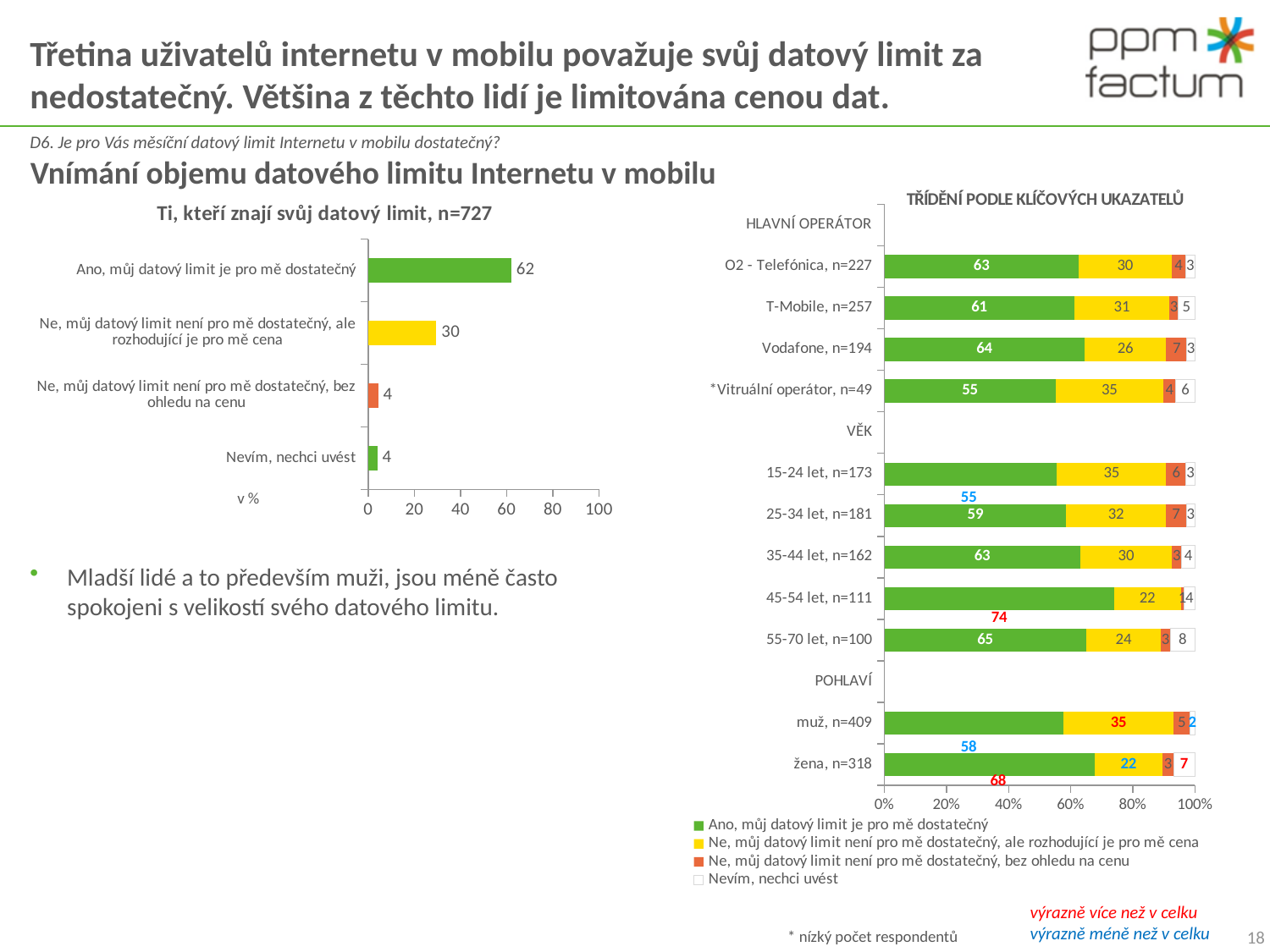
In the right chart 'TŘÍDĚNÍ PODLE KLÍČOVÝCH UKAZATELŮ', what is the value of 'Ano, můj datový limit je pro mě dostatečný' for '45-54 let, n=111'? 74 In the right chart 'TŘÍDĚNÍ PODLE KLÍČOVÝCH UKAZATELŮ', which has the larger value for 'Ano, můj datový limit je pro mě dostatečný': 'žena, n=318' or 'muž, n=409'? žena, n=318 In the right chart 'TŘÍDĚNÍ PODLE KLÍČOVÝCH UKAZATELŮ', what is the value of 'Ne, můj datový limit není pro mě dostatečný, ale rozhodující je pro mě cena' for 'muž, n=409'? 35 In the right chart 'TŘÍDĚNÍ PODLE KLÍČOVÝCH UKAZATELŮ', which age group has the highest value for 'Ano, můj datový limit je pro mě dostatečný'? 45-54 let, n=111 In the right chart 'TŘÍDĚNÍ PODLE KLÍČOVÝCH UKAZATELŮ', how many series does the legend list? 4 In the right chart 'TŘÍDĚNÍ PODLE KLÍČOVÝCH UKAZATELŮ', which age group has the lowest value for 'Ano, můj datový limit je pro mě dostatečný'? 15-24 let, n=173 In the right chart 'TŘÍDĚNÍ PODLE KLÍČOVÝCH UKAZATELŮ', what is the value of 'Ano, můj datový limit je pro mě dostatečný' for 'O2 - Telefónica, n=227'? 63 What kind of chart is the left chart 'Ti, kteří znají svůj datový limit, n=727'? Bar chart In the left chart 'Ti, kteří znají svůj datový limit, n=727', how many categories are shown? 4 In the left chart 'Ti, kteří znají svůj datový limit, n=727', which category has the highest value? Ano, můj datový limit je pro mě dostatečný In the left chart 'Ti, kteří znají svůj datový limit, n=727', what is the value for 'Ano, můj datový limit je pro mě dostatečný'? 62 In the left chart 'Ti, kteří znají svůj datový limit, n=727', what is the difference between 'Ano, můj datový limit je pro mě dostatečný' and 'Ne, můj datový limit není pro mě dostatečný, ale rozhodující je pro mě cena'? 32